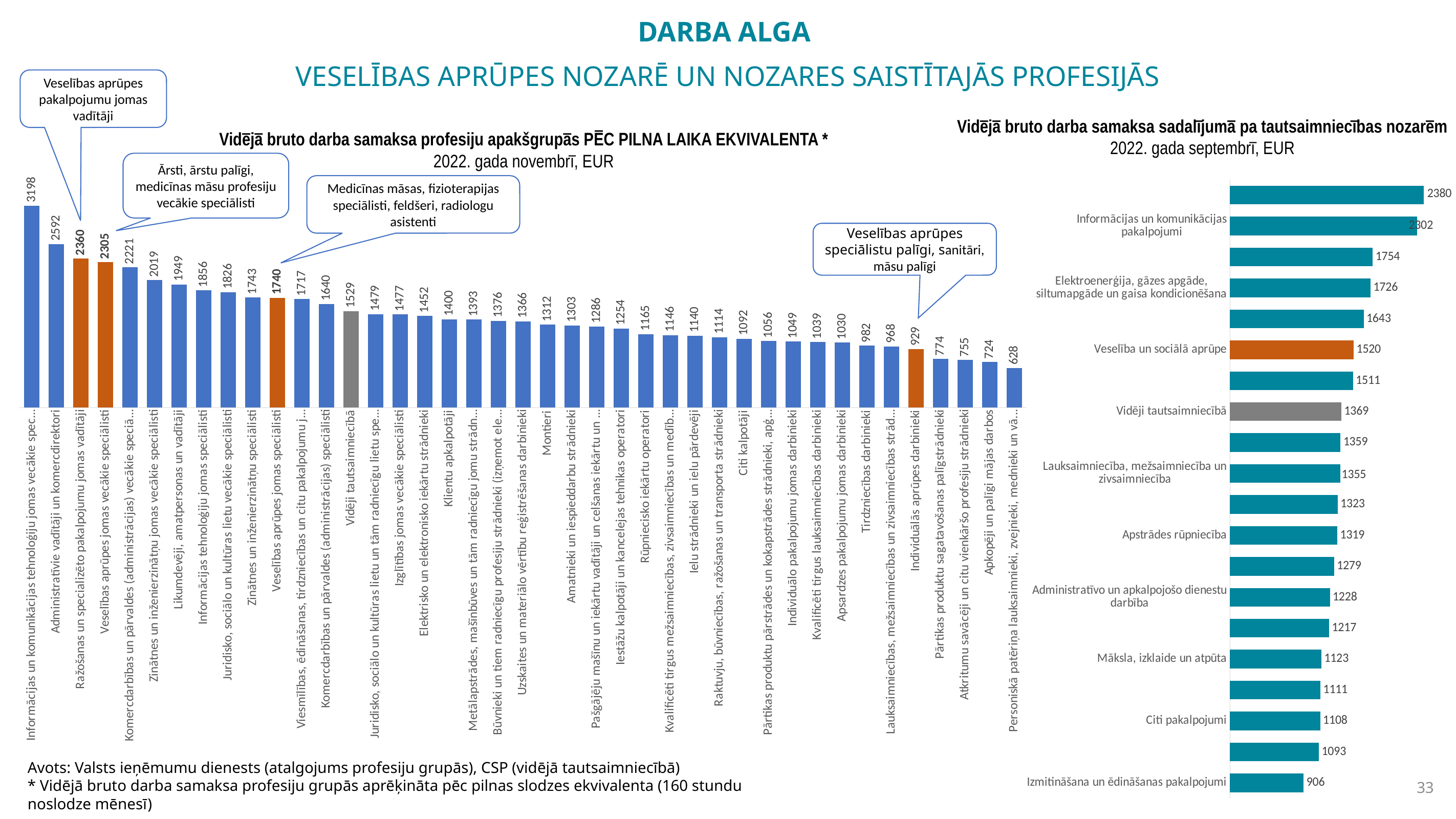
In the left chart (Vidējā bruto darba samaksa profesiju apakšgrupās), what is the value for Individuālās aprūpes darbinieki? 929 In the left chart (Vidējā bruto darba samaksa profesiju apakšgrupās), what is the value for Administratīvie vadītāji un komercdirektori? 2592 In the right chart (Vidējā bruto darba samaksa sadalījumā pa tautsaimniecības nozarēm), what is the difference between Veselība un sociālā aprūpe and Vidēji tautsaimniecībā? 151 In the left chart (Vidējā bruto darba samaksa profesiju apakšgrupās), what is the highest value shown? 3198 What type of chart is the right chart (Vidējā bruto darba samaksa sadalījumā pa tautsaimniecības nozarēm)? Bar chart In the left chart (Vidējā bruto darba samaksa profesiju apakšgrupās), which is larger: Klientu apkalpotāji or Rūpniecisko iekārtu operatori? Klientu apkalpotāji In the left chart (Vidējā bruto darba samaksa profesiju apakšgrupās), what is the difference between Montieri and Apkopēji un palīgi mājas darbos? 588 In the left chart (Vidējā bruto darba samaksa profesiju apakšgrupās), what is the value for Veselības aprūpes jomas vecākie speciālisti? 2305 In the left chart (Vidējā bruto darba samaksa profesiju apakšgrupās), which category has the lowest value? Personiskā patēriņa lauksaimnieki, zvejnieki, mednieki un vā... In the right chart (Vidējā bruto darba samaksa sadalījumā pa tautsaimniecības nozarēm), what is the value for Izmitināšana un ēdināšanas pakalpojumi? 906 In the right chart (Vidējā bruto darba samaksa sadalījumā pa tautsaimniecības nozarēm), what is the value for Veselība un sociālā aprūpe? 1520 In the left chart (Vidējā bruto darba samaksa profesiju apakšgrupās), what is the value for Vidēji tautsaimniecībā? 1529